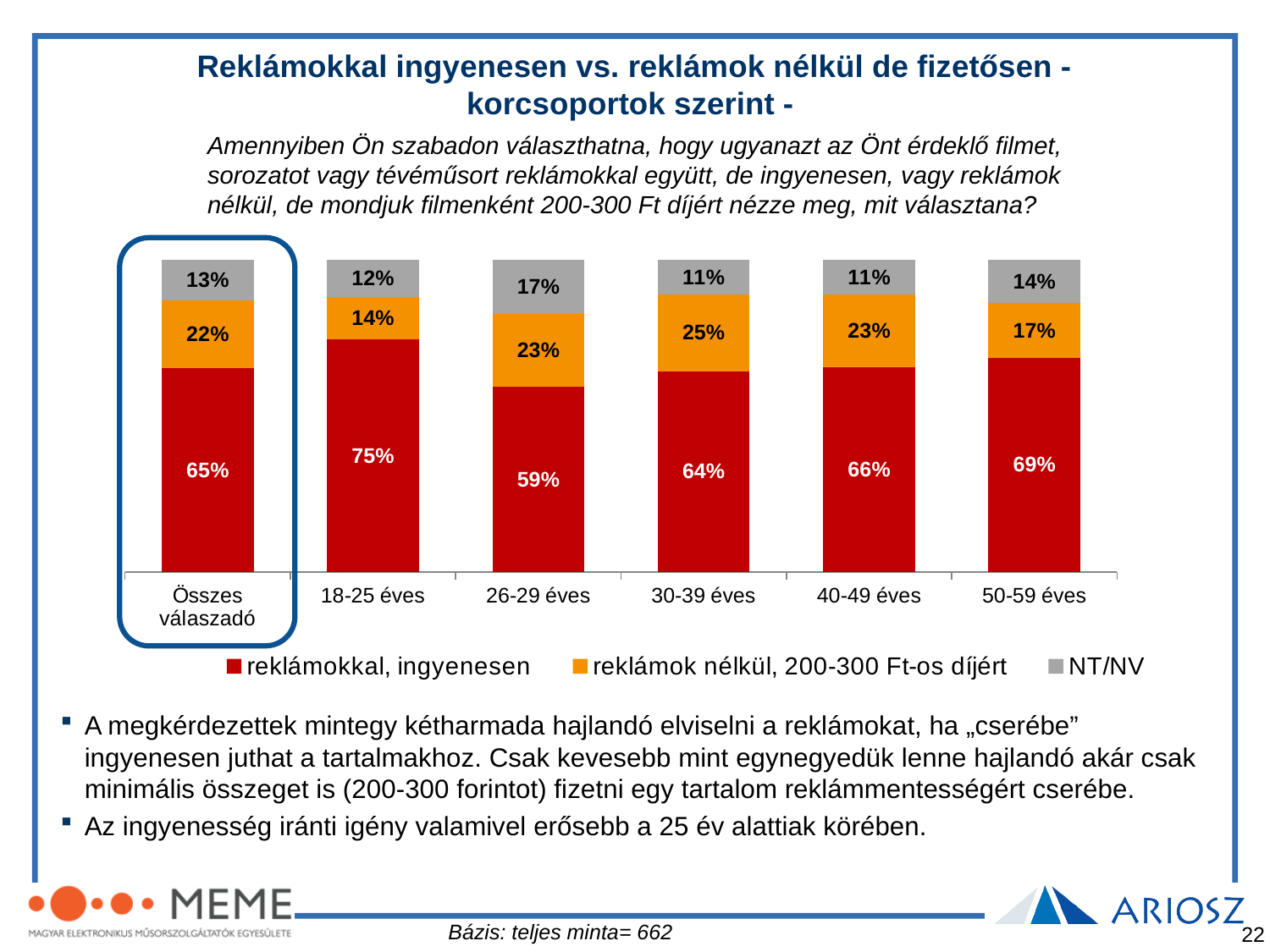
Which category has the lowest value for "reklámokkal, ingyenesen"? 26-29 éves Which is larger: the "reklámok nélkül, 200-300 Ft-os díjért" value for 40-49 éves or for 50-59 éves? 40-49 éves Which age group has the highest value for "reklámokkal, ingyenesen"? 18-25 éves What kind of chart is shown on the slide? Stacked bar chart What is the difference between the "reklámokkal, ingyenesen" values for 18-25 éves and 26-29 éves? 16 percentage points What percentage of respondents aged 18-25 chose "reklámokkal, ingyenesen"? 75% How many series does the legend list? 3 How many categories are shown on the x axis of the chart? 6 What share of the 30-39 éves group chose "reklámok nélkül, 200-300 Ft-os díjért"? 25% What is the "NT/NV" value for the 26-29 éves group? 17% What is the total of the stacked bar for Összes válaszadó? 100% Which category on the chart is highlighted with a rounded outline? Összes válaszadó